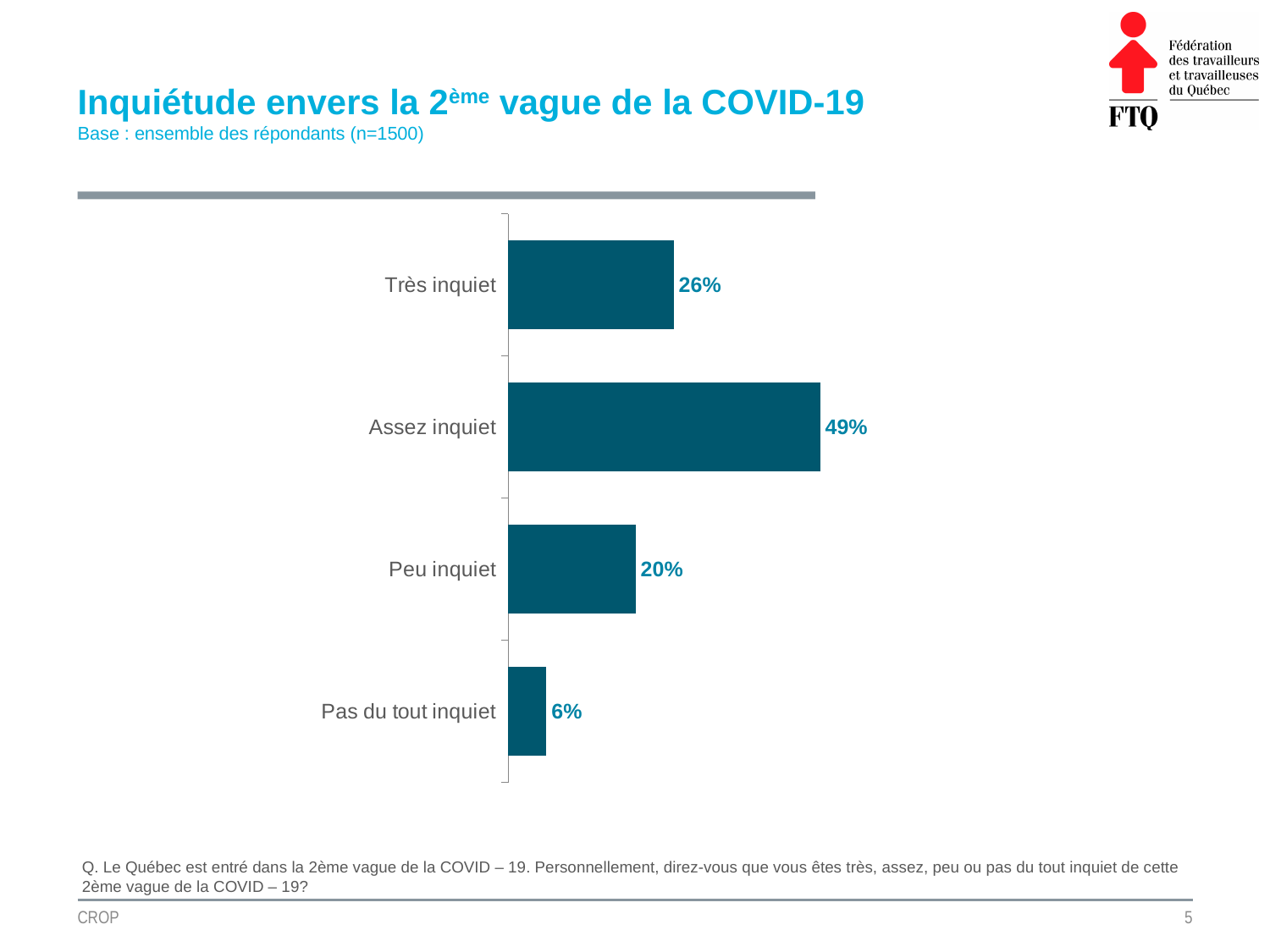
What percentage of respondents are "Pas du tout inquiet"? 6% What is the difference in percentage points between "Assez inquiet" and "Très inquiet"? 23 What percentage of respondents are "Très inquiet"? 26% What kind of chart is shown on the slide? Bar chart Which category has the lowest percentage? Pas du tout inquiet Which category has the highest percentage? Assez inquiet What percentage of respondents are "Peu inquiet"? 20% What percentage of respondents are "Assez inquiet"? 49% What is the difference in percentage points between "Peu inquiet" and "Pas du tout inquiet"? 14 How many categories are shown in the chart? 4 What is the title of the chart on the slide? Inquiétude envers la 2ème vague de la COVID-19 Which is larger, the value for "Très inquiet" or the value for "Peu inquiet"? Très inquiet